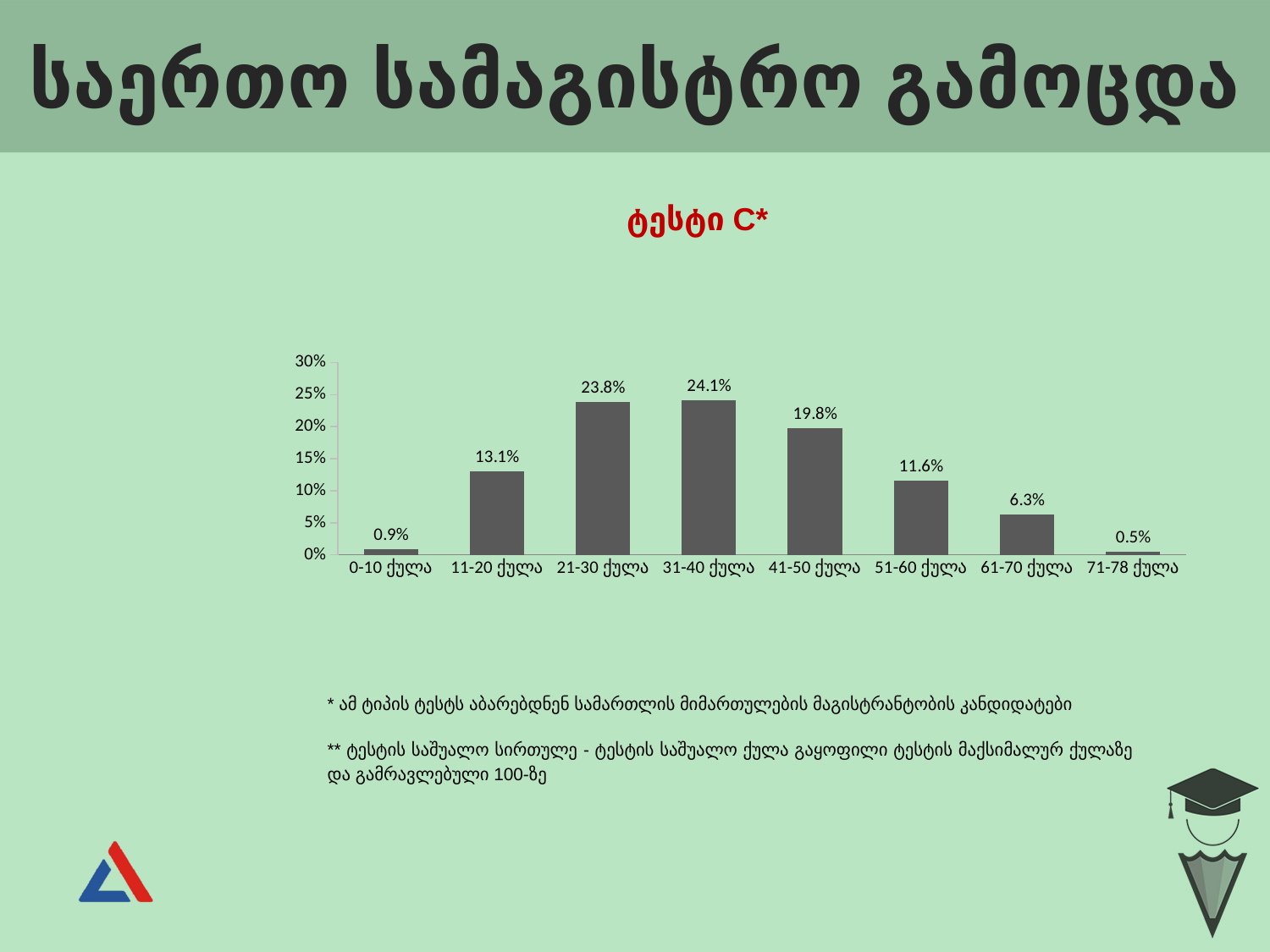
How many categories are shown on the x axis? 8 Which is larger, the value for 41-50 ქულა or the value for 51-60 ქულა? 41-50 ქულა What is the value for the 31-40 ქულა category? 24.1% What is the value for the 0-10 ქულა category? 0.9% What kind of chart is shown on the slide? bar chart Do the values rise or fall from 31-40 ქულა to 71-78 ქულა? fall Which category has the highest value? 31-40 ქულა Which category has the lowest value? 71-78 ქულა What is the difference between the values for 21-30 ქულა and 11-20 ქულა? 10.7% What is the title of the chart? ტესტი C* What is the value for the 61-70 ქულა category? 6.3% Is the value for 11-20 ქულა greater or less than 10%? greater